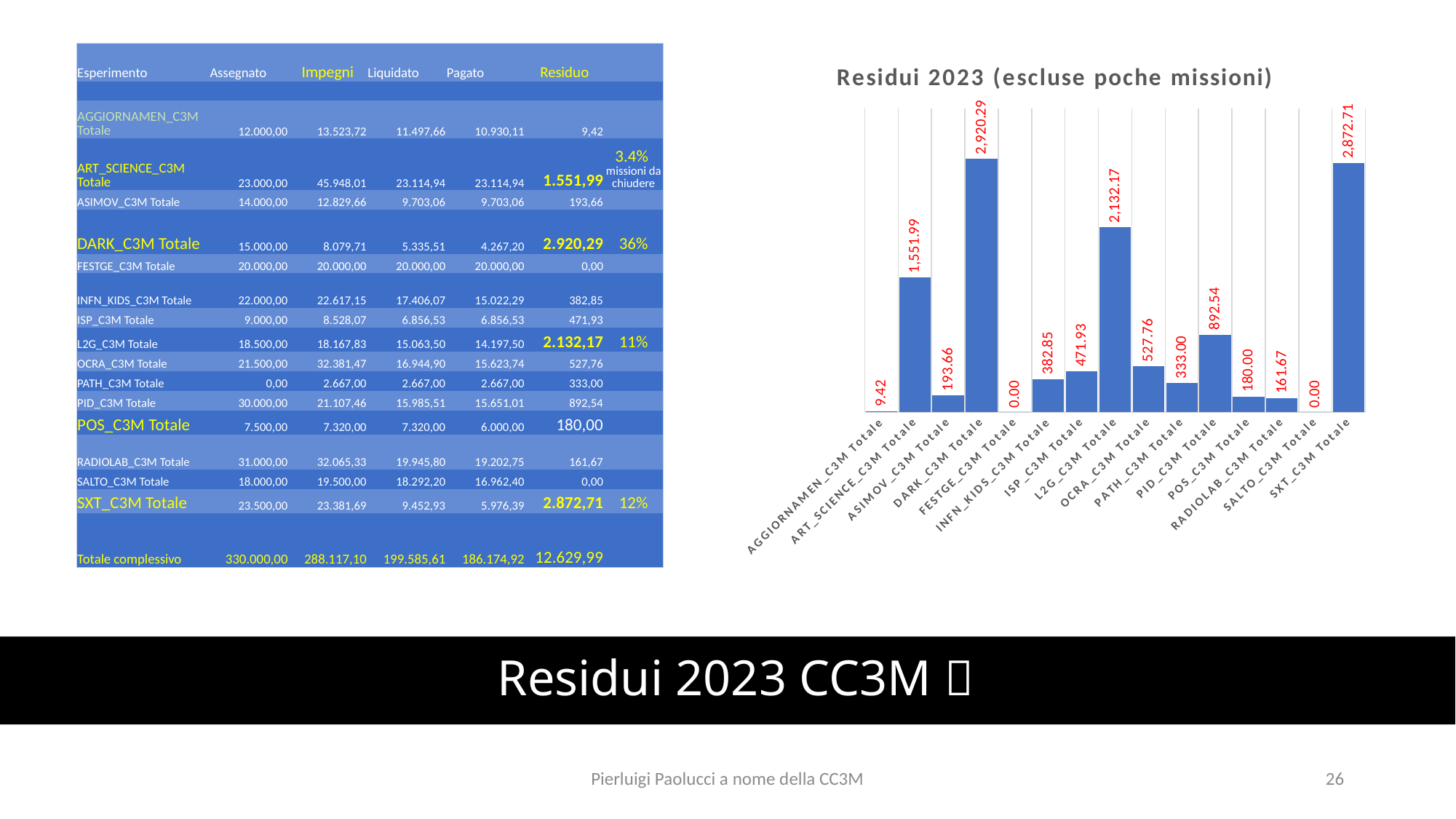
What type of chart is shown on the slide? bar chart Which is larger, the value for ISP_C3M Totale or the value for OCRA_C3M Totale? OCRA_C3M Totale Which two categories have a value of 0.00 in the chart? FESTGE_C3M Totale and SALTO_C3M Totale What is the difference between the values for DARK_C3M Totale and SXT_C3M Totale? 47.58 Which category has the highest value in the chart? DARK_C3M Totale What is the value for RADIOLAB_C3M Totale in the chart? 161.67 What is the value for PID_C3M Totale in the chart? 892.54 How many categories are plotted in the chart? 15 What is the value for L2G_C3M Totale in the chart? 2,132.17 What is the difference between the values for L2G_C3M Totale and ART_SCIENCE_C3M Totale? 580.18 What is the title of the chart? Residui 2023 (escluse poche missioni) What is the value for DARK_C3M Totale in the chart? 2,920.29